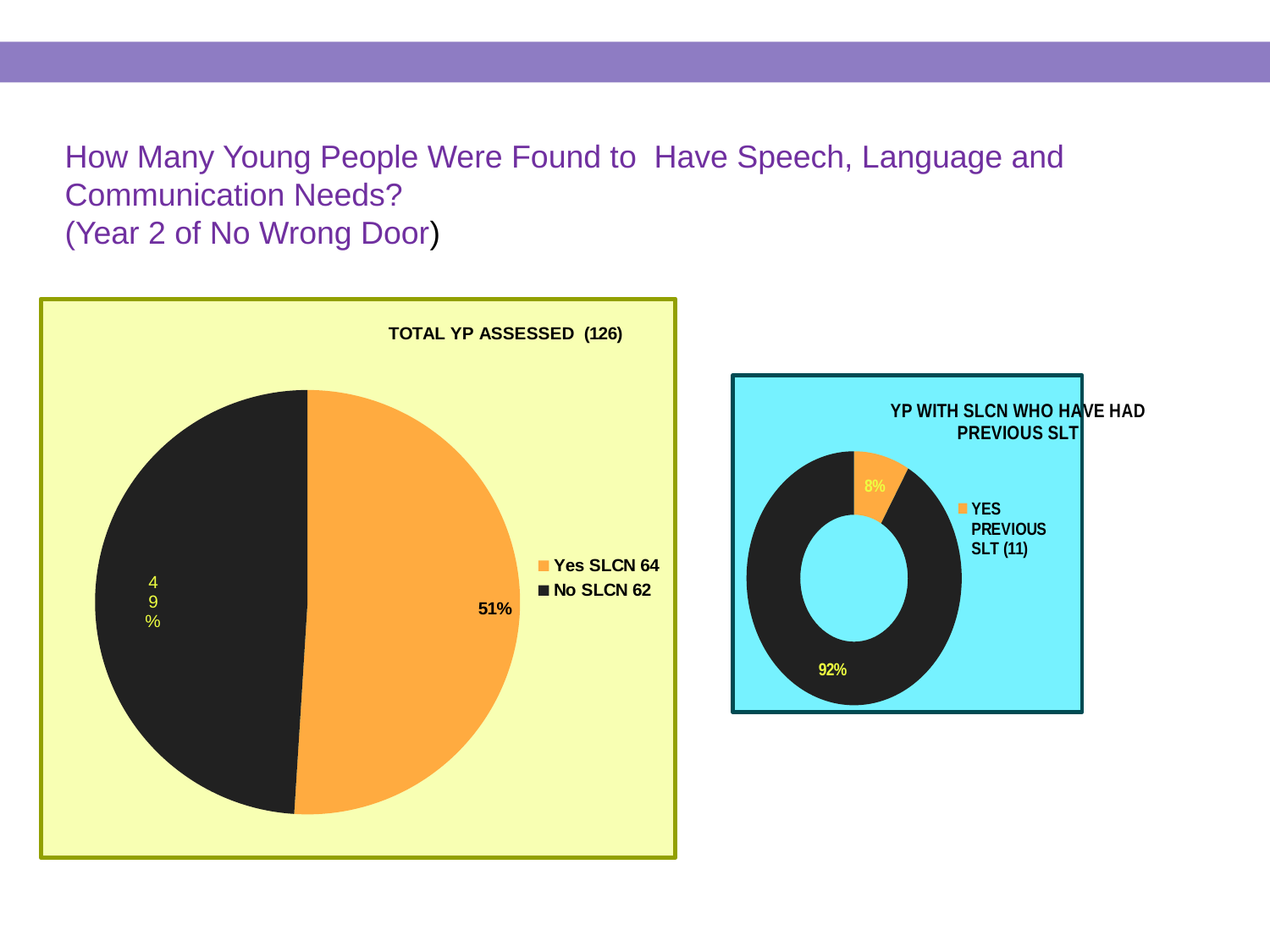
What kind of chart is the one titled "TOTAL YP ASSESSED (126)"? Pie chart In the chart titled "TOTAL YP ASSESSED (126)", what share of the pie is labelled for the No SLCN slice? 49% In the chart titled "TOTAL YP ASSESSED (126)", what is the difference between the Yes SLCN count and the No SLCN count shown in the legend? 2 In the chart titled "TOTAL YP ASSESSED (126)", how many young people are listed in the legend for No SLCN? 62 In the chart titled "YP WITH SLCN WHO HAVE HAD PREVIOUS SLT", what share is labelled for the YES PREVIOUS SLT slice? 8% In the chart titled "TOTAL YP ASSESSED (126)", which slice is larger, Yes SLCN or No SLCN? Yes SLCN In the chart titled "YP WITH SLCN WHO HAVE HAD PREVIOUS SLT", what share is labelled on the large black slice? 92% In the chart titled "YP WITH SLCN WHO HAVE HAD PREVIOUS SLT", how many young people does the legend give for YES PREVIOUS SLT? 11 In the chart titled "TOTAL YP ASSESSED (126)", what colour is the Yes SLCN slice? Orange In the chart titled "TOTAL YP ASSESSED (126)", how many young people are listed in the legend for Yes SLCN? 64 In the chart titled "TOTAL YP ASSESSED (126)", how many entries does the legend list? 2